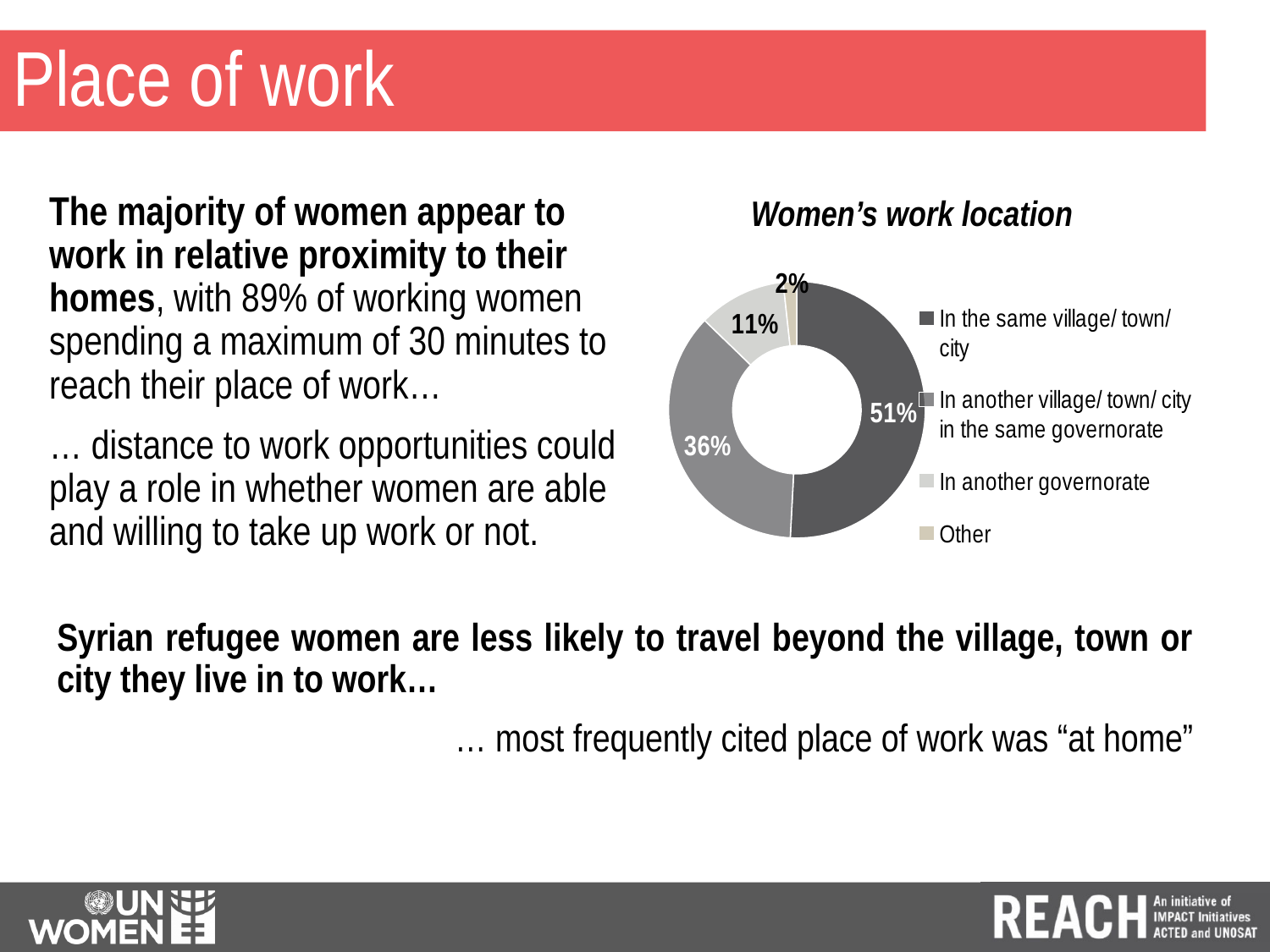
How many categories does the chart show? 4 What share of women work in another governorate? 11% Which work location category has the largest share? In the same village/ town/ city What kind of chart is shown on the slide? Doughnut (pie) chart What is the difference between the share working in the same village/ town/ city and the share working in another village/ town/ city in the same governorate? 15% Which is larger: the share working in another governorate or the share in 'Other'? In another governorate What share of women fall under 'Other' for work location? 2% What share of women work in another village/ town/ city in the same governorate? 36% What is the combined share of women working in the same village/ town/ city and in another village/ town/ city in the same governorate? 87% Which work location category has the smallest share? Other What is the title of the chart? Women's work location What share of women work in the same village/ town/ city? 51%